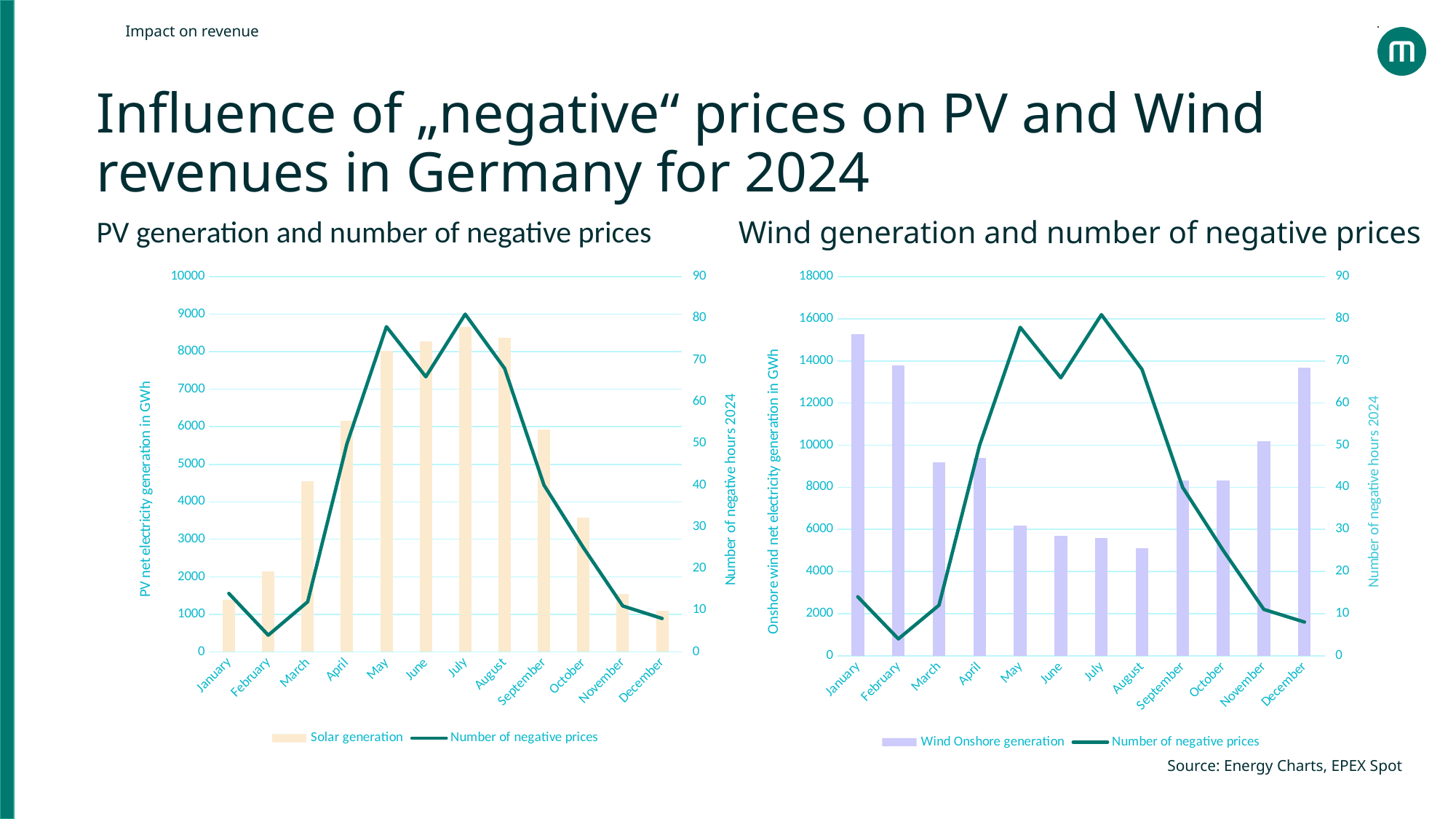
In the chart titled "Wind generation and number of negative prices", is the wind onshore generation for December greater or less than 12000? greater In the chart titled "PV generation and number of negative prices", in which month is the number of negative prices lowest? February In the chart titled "PV generation and number of negative prices", does solar generation rise or fall from August to December? fall In the chart titled "Wind generation and number of negative prices", is the number of negative prices for September greater or less than 30? greater In the chart titled "PV generation and number of negative prices", is the solar generation for October greater or less than 4000? less In the chart titled "PV generation and number of negative prices", which month has the lowest solar generation? December In the chart titled "Wind generation and number of negative prices", which month has the highest wind onshore generation? January In the chart titled "Wind generation and number of negative prices", in which month is the number of negative prices lowest? February How many months are shown on the x axis of the chart titled "Wind generation and number of negative prices"? 12 How many series does the legend of the chart titled "PV generation and number of negative prices" list? 2 In the chart titled "PV generation and number of negative prices", which is larger, the solar generation for March or for February? March